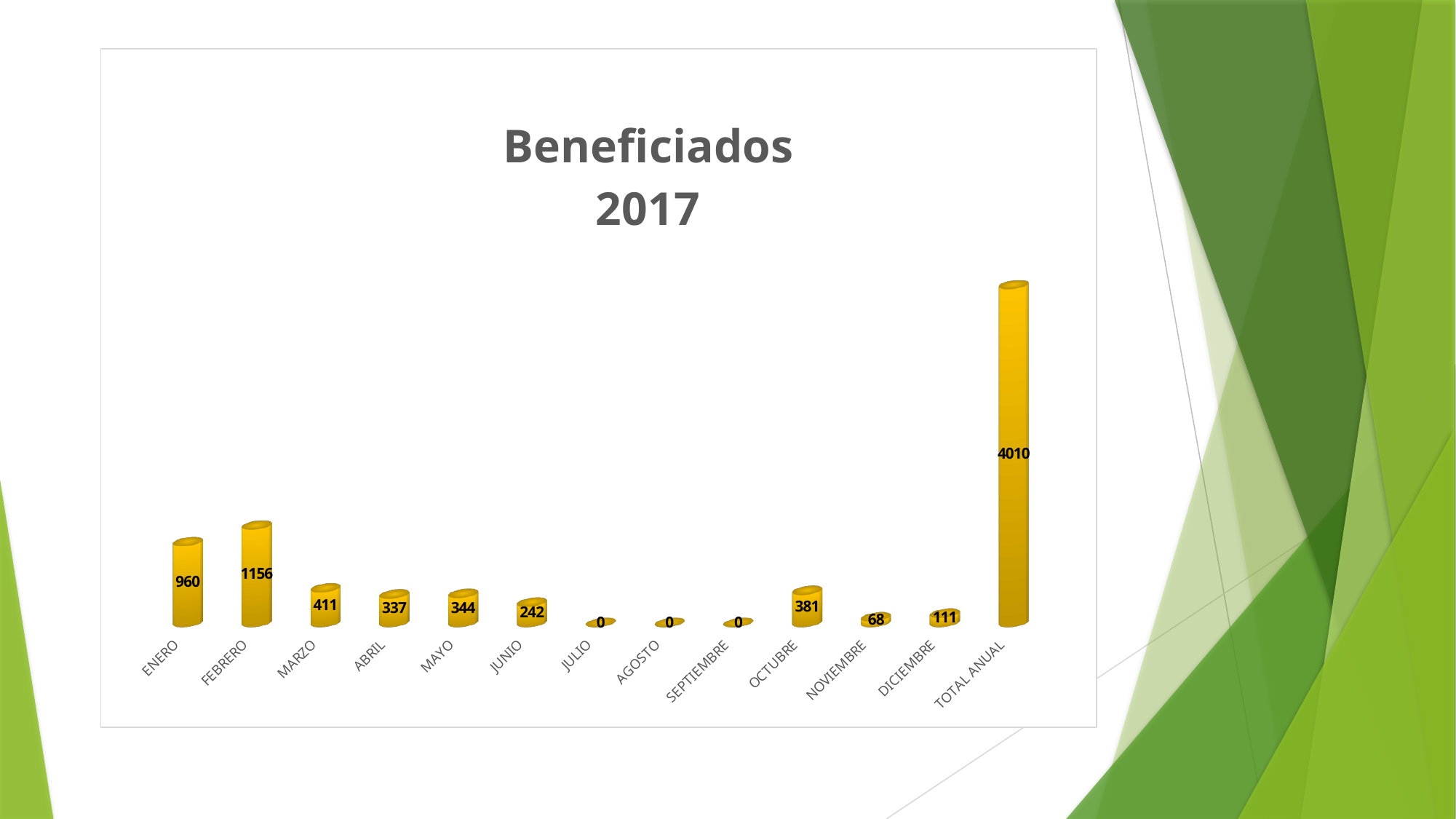
What is the value for OCTUBRE? 381 What is the title of the chart? Beneficiados 2017 What is the value for TOTAL ANUAL? 4010 How many categories are shown on the x axis? 13 Which is larger, the value for MARZO or the value for ABRIL? MARZO What is the value for FEBRERO? 1156 What is the difference between the values for FEBRERO and ENERO? 196 What kind of chart is this? bar chart Which category has the highest value overall? TOTAL ANUAL How many months have a value of 0? 3 What is the value for NOVIEMBRE? 68 Which month has the highest value? FEBRERO